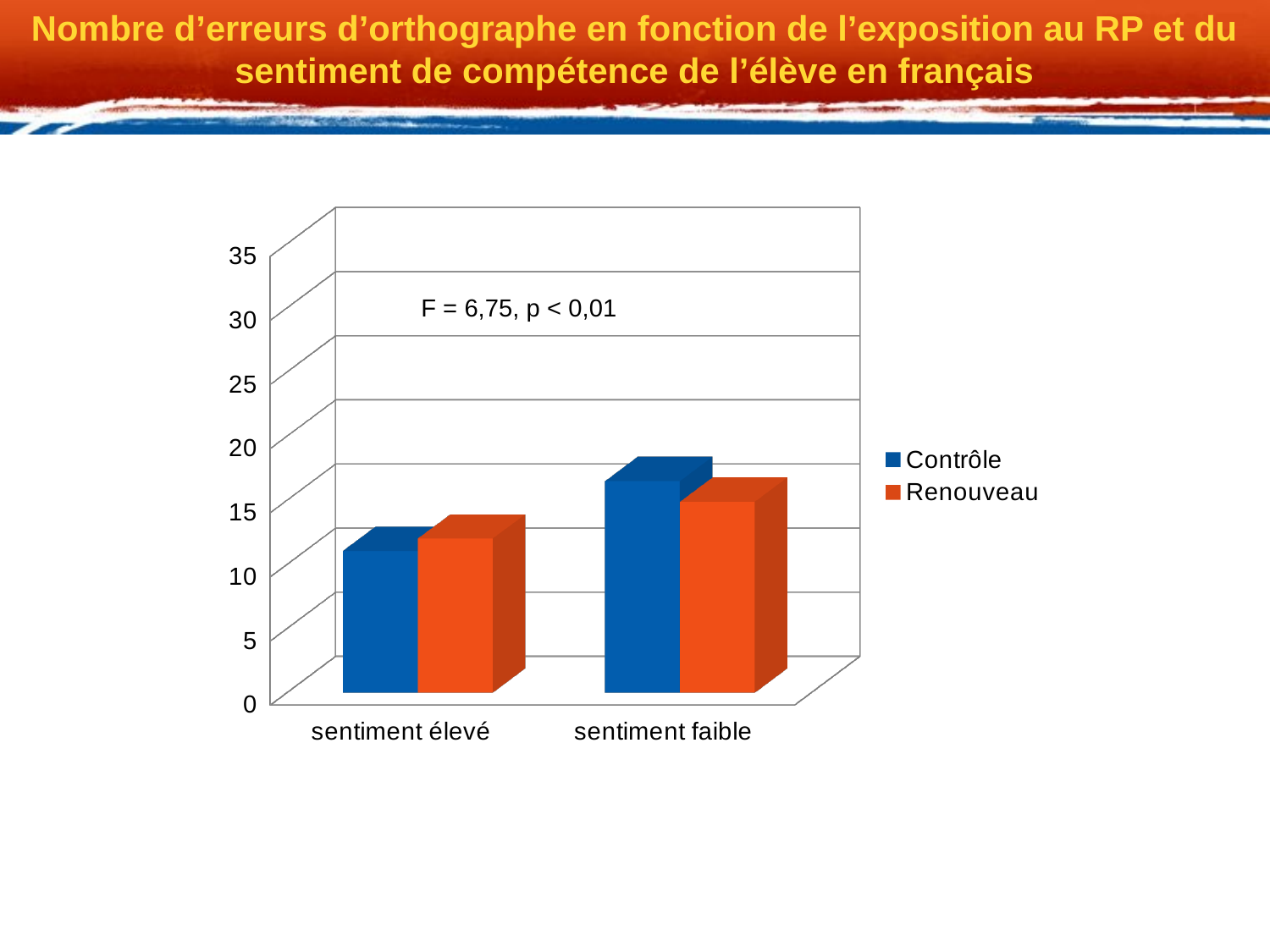
What statistical annotation is printed inside the chart area? F = 6,75, p < 0,01 Do the values for the Contrôle series rise or fall from sentiment élevé to sentiment faible? rise What kind of chart is shown on the slide? bar chart For the sentiment faible category, which series has the larger value, Contrôle or Renouveau? Contrôle Which bar is the tallest in the chart? Contrôle at sentiment faible How many series does the legend list? 2 Is the value for Renouveau at sentiment faible greater or less than 10? greater Is the value for Renouveau at sentiment élevé greater or less than 15? less Which series is shown in blue in the legend? Contrôle Is the value for Contrôle at sentiment élevé greater or less than 15? less How many categories are shown on the x axis? 2